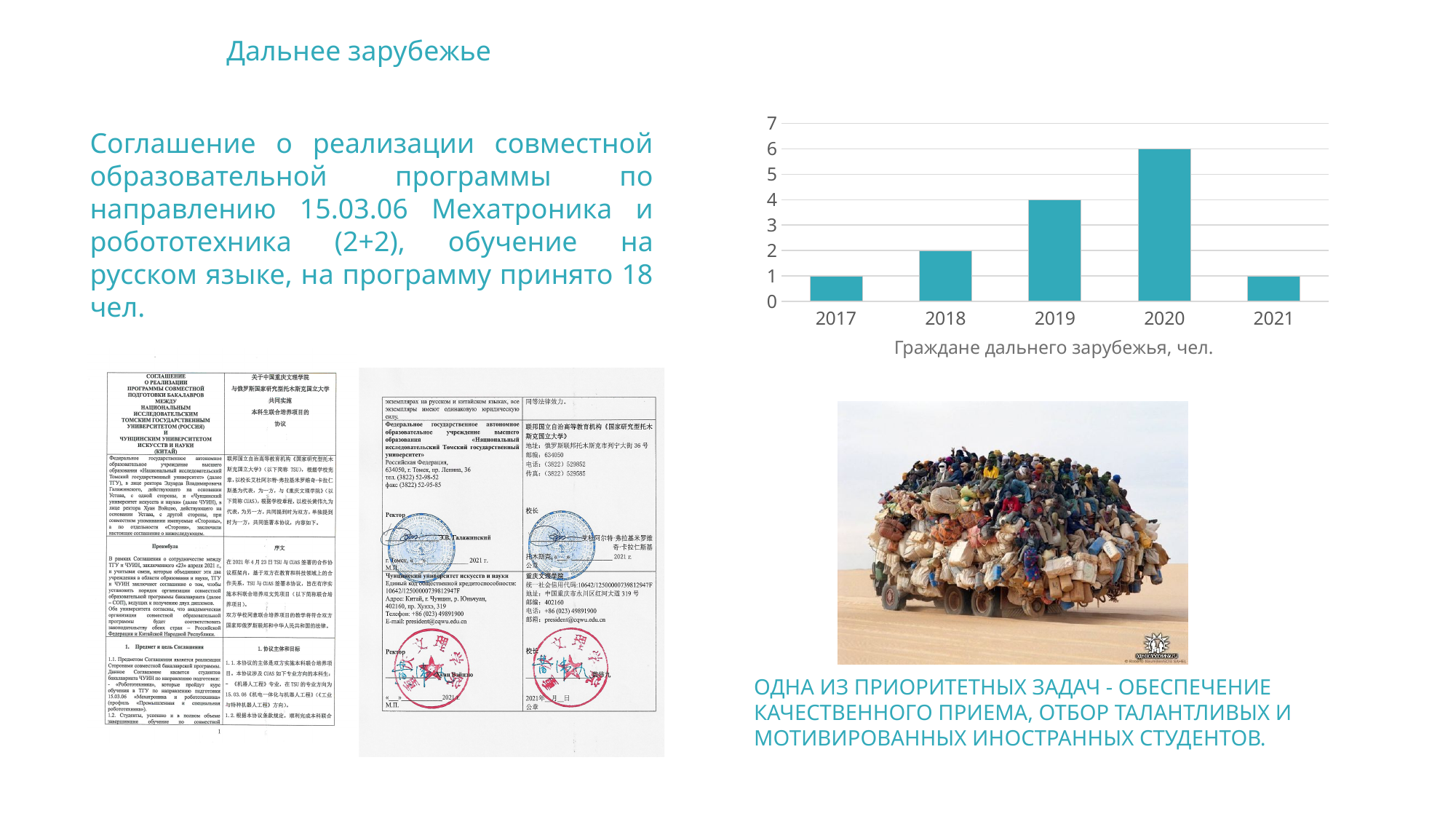
What is the value for 2019 in the chart? 4 What is the value for 2020 in the chart? 6 Which is larger, the value for 2019 or the value for 2018? 2019 What is the value for 2017 in the chart? 1 What is the difference between the values for 2020 and 2019? 2 What kind of chart is shown on the slide? bar chart What is the value for 2018 in the chart? 2 Is the value for 2020 greater or less than 5? greater How many years are shown on the x axis of the chart? 5 Which year has the highest value in the chart? 2020